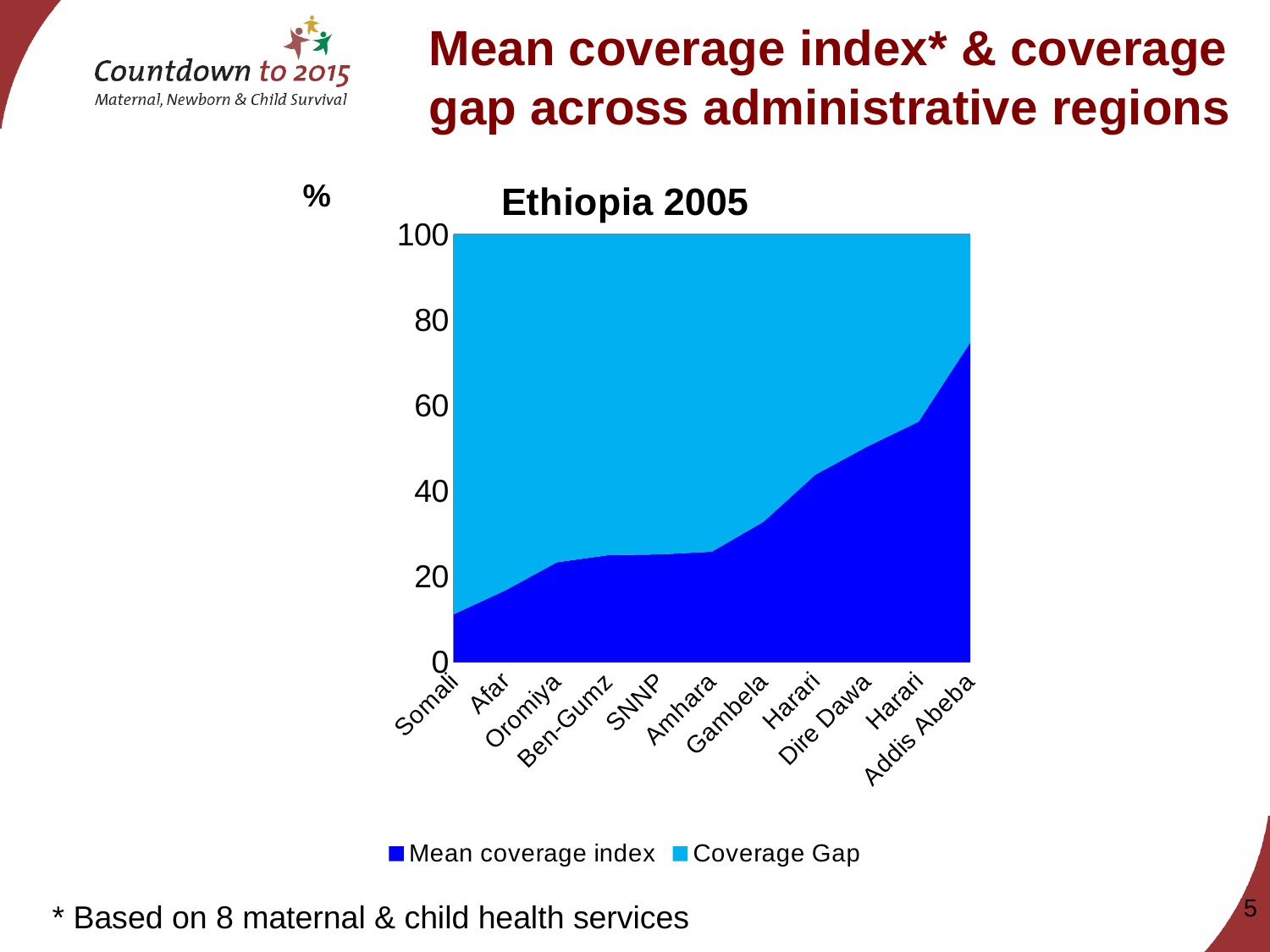
What is the title shown above the chart? Ethiopia 2005 How many series does the legend list? 2 Which region has the lowest mean coverage index? Somali Which series is shown in dark blue in the legend? Mean coverage index Which is larger, the mean coverage index for Addis Abeba or for Somali? Addis Abeba Does the mean coverage index rise or fall moving from Somali to Addis Abeba along the x axis? Rises Is the mean coverage index for Gambela greater or less than 40? less Is the mean coverage index for Addis Abeba greater or less than 60? greater Which region has the highest mean coverage index? Addis Abeba How many administrative regions are shown along the x axis? 11 What kind of chart is shown on the slide? Stacked area chart Is the mean coverage index for Somali greater or less than 20? less